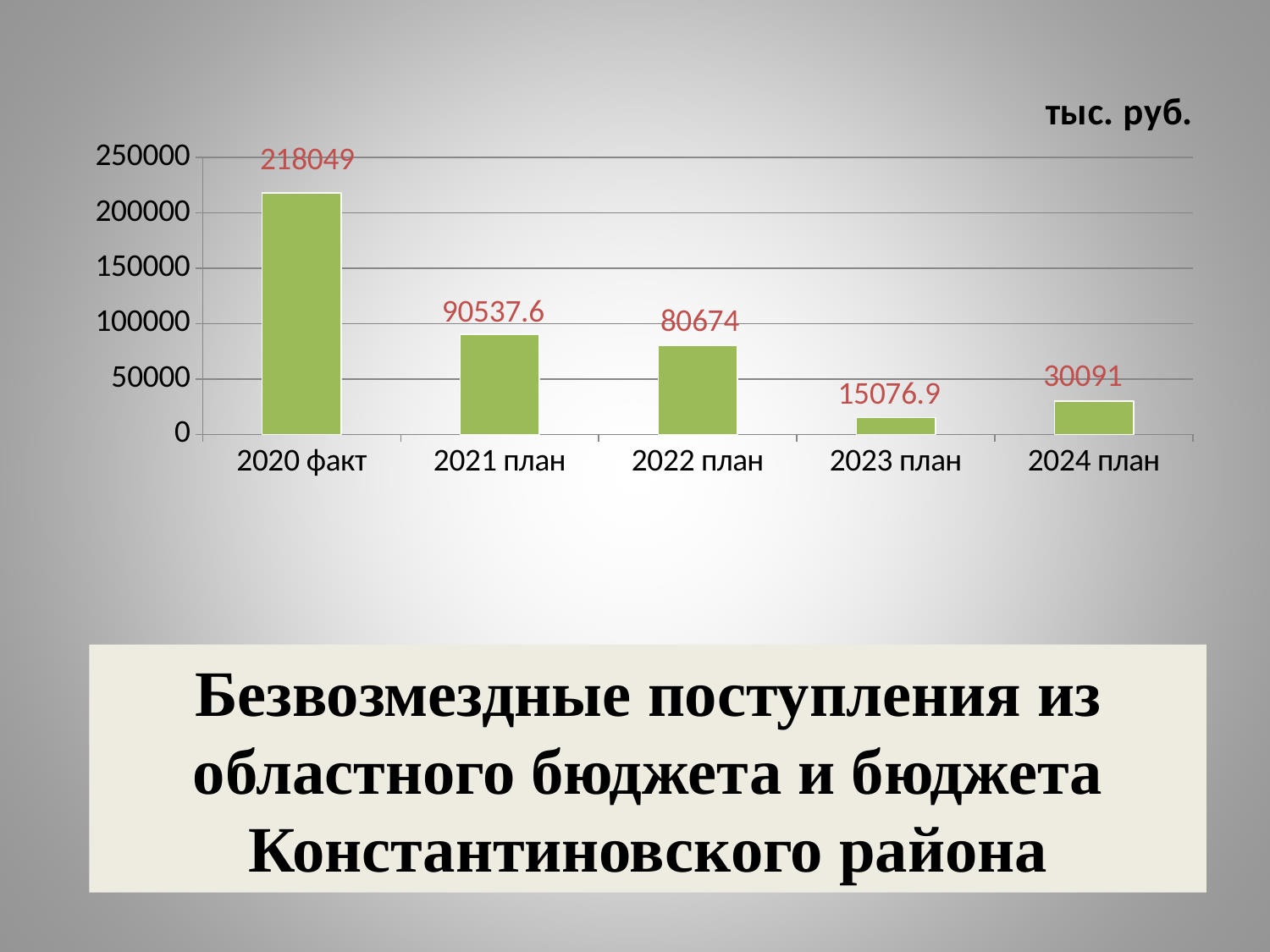
What is the difference between the values for 2024 план and 2023 план? 15014.1 What is the value for 2023 план? 15076.9 What is the difference between the values for 2020 факт and 2021 план? 127511.4 What is the value for 2024 план? 30091 Which category has the lowest value? 2023 план What is the value for 2020 факт? 218049 Which is larger, the value for 2022 план or the value for 2024 план? 2022 план What is the value for 2021 план? 90537.6 What kind of chart is shown on the slide? Bar chart What unit is indicated for the values in the chart? тыс. руб. How many categories are shown on the x axis? 5 Which category has the highest value? 2020 факт